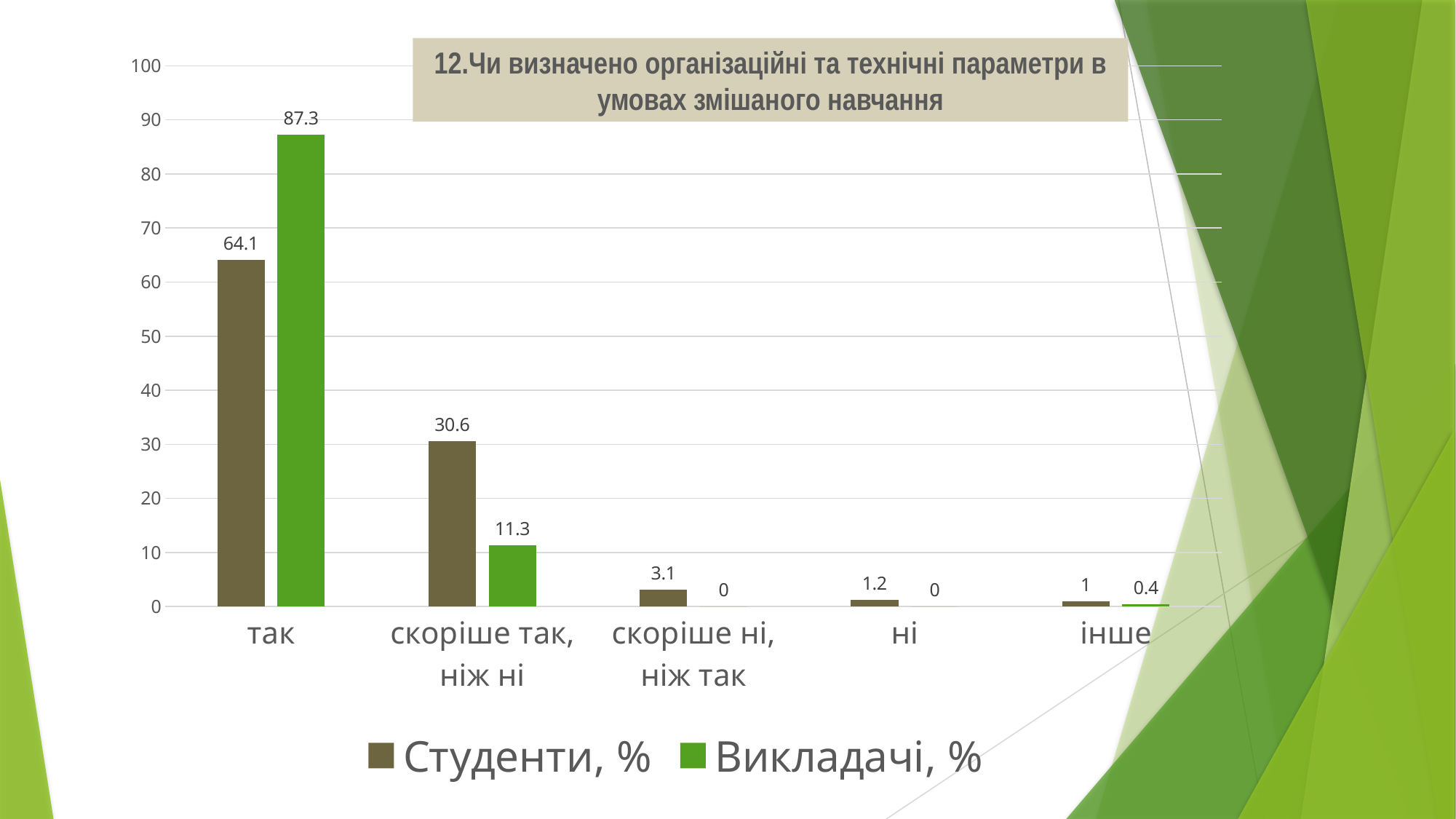
How many series does the legend list? 2 What is the value for Студенти, % in the category ні? 1.2 What is the value for Викладачі, % in the category скоріше так, ніж ні? 11.3 What is the difference between Викладачі, % and Студенти, % in the category так? 23.2 What is the value for Студенти, % in the category так? 64.1 How many categories are shown on the x axis? 5 What kind of chart is shown on the slide? bar chart Which colour represents the series Викладачі, % in the chart? green Which category has the lowest value for Студенти, %? інше Which category has the highest value for Викладачі, %? так In the category скоріше так, ніж ні, which series has the larger value, Студенти, % or Викладачі, %? Студенти, % What is the value for Викладачі, % in the category так? 87.3